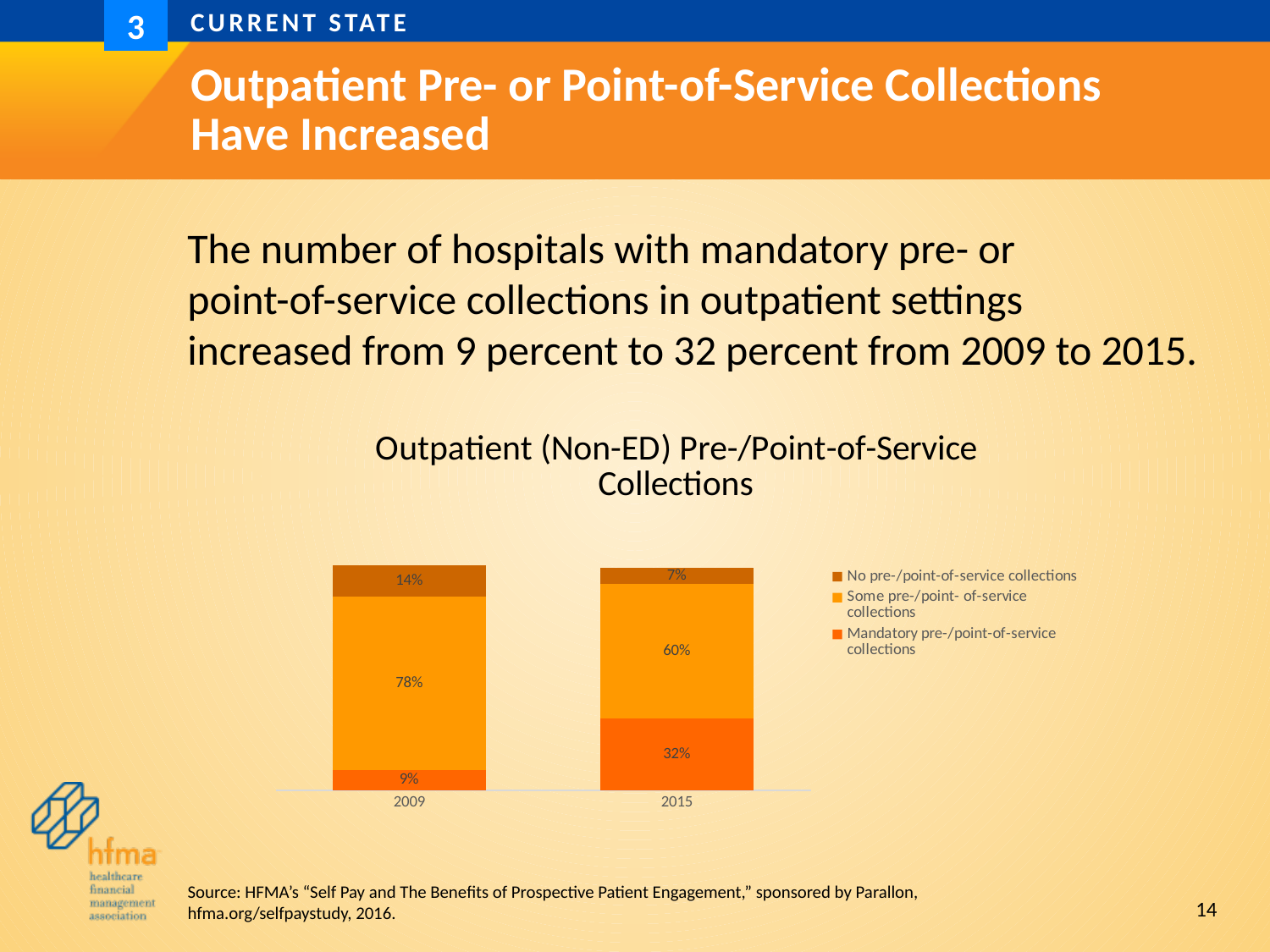
Which segment is the largest in the 2015 bar? Some pre-/point-of-service collections How many series does the chart legend list? 3 What percentage of hospitals had no pre-/point-of-service collections in 2015? 7% What percentage of hospitals had some pre-/point-of-service collections in 2009? 78% Which segment is the smallest in the 2009 bar? Mandatory pre-/point-of-service collections What is the difference between the 'Some pre-/point-of-service collections' values for 2009 and 2015? 18 percentage points What percentage of hospitals had mandatory pre-/point-of-service collections in 2015? 32% How many years are shown on the x axis of the chart? 2 Which year has the larger share of hospitals with no pre-/point-of-service collections, 2009 or 2015? 2009 By how many percentage points did the share of hospitals with mandatory pre-/point-of-service collections change from 2009 to 2015? 23 percentage points What percentage of hospitals had mandatory pre-/point-of-service collections in 2009? 9% What type of chart is shown on the slide? Stacked bar chart